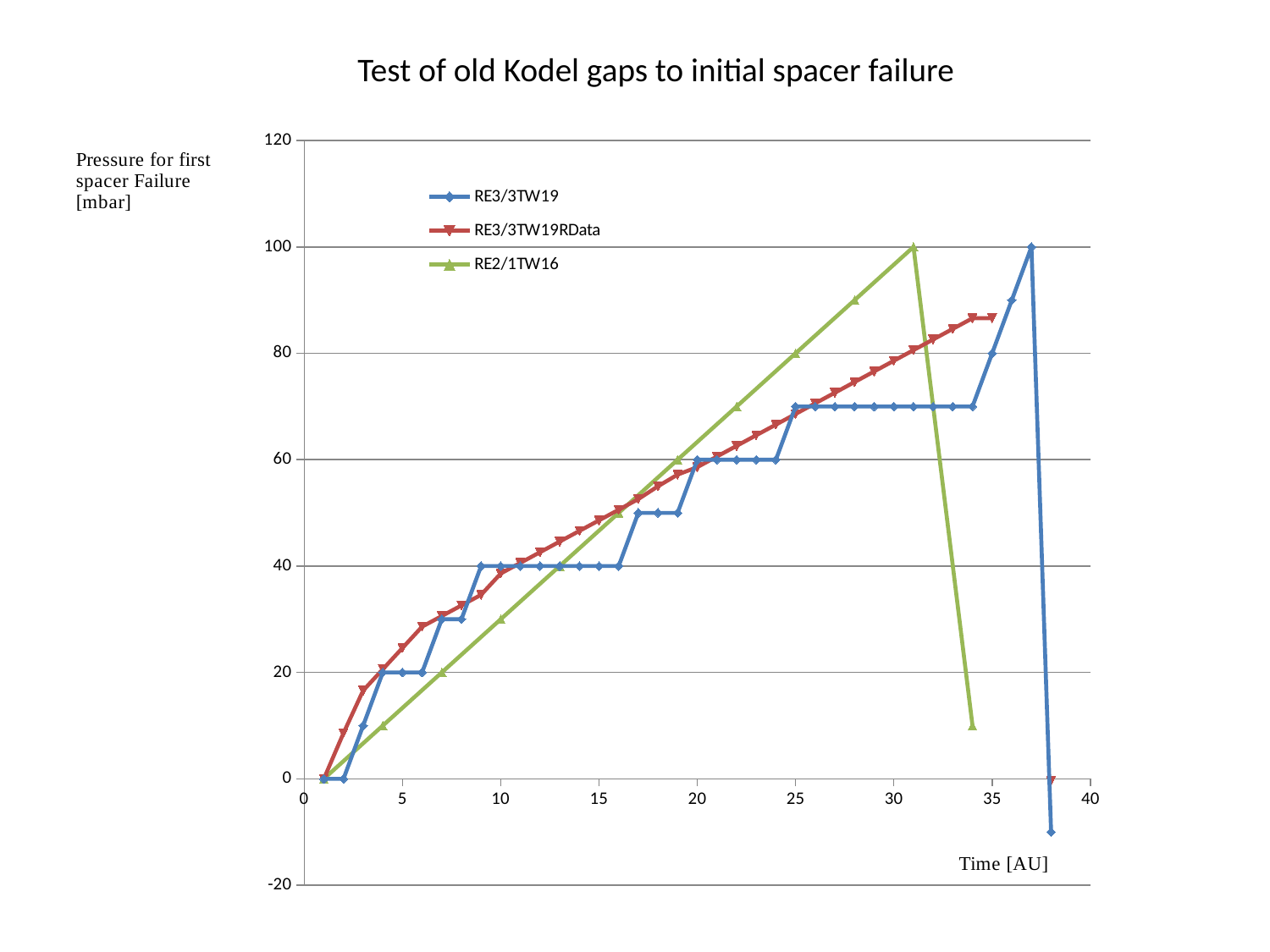
Is the value of the RE3/3TW19RData series at time 30 greater or less than 60? greater What is the label of the x axis? Time [AU] Which series drops below 0 at the end of its run? RE3/3TW19 What are the three series named in the legend? RE3/3TW19, RE3/3TW19RData, RE2/1TW16 At time 30, which series has the higher value, RE2/1TW16 or RE3/3TW19? RE2/1TW16 Is the value of the RE2/1TW16 series at time 34 greater or less than 20? less What kind of chart is shown on the slide? line chart What is the value of the RE3/3TW19 series at time 20? 60 How many series does the legend list? 3 At time 5, which series has the higher value, RE3/3TW19RData or RE2/1TW16? RE3/3TW19RData What is the value of the RE3/3TW19 series at time 10? 40 What is the peak value reached by the RE2/1TW16 series? 100